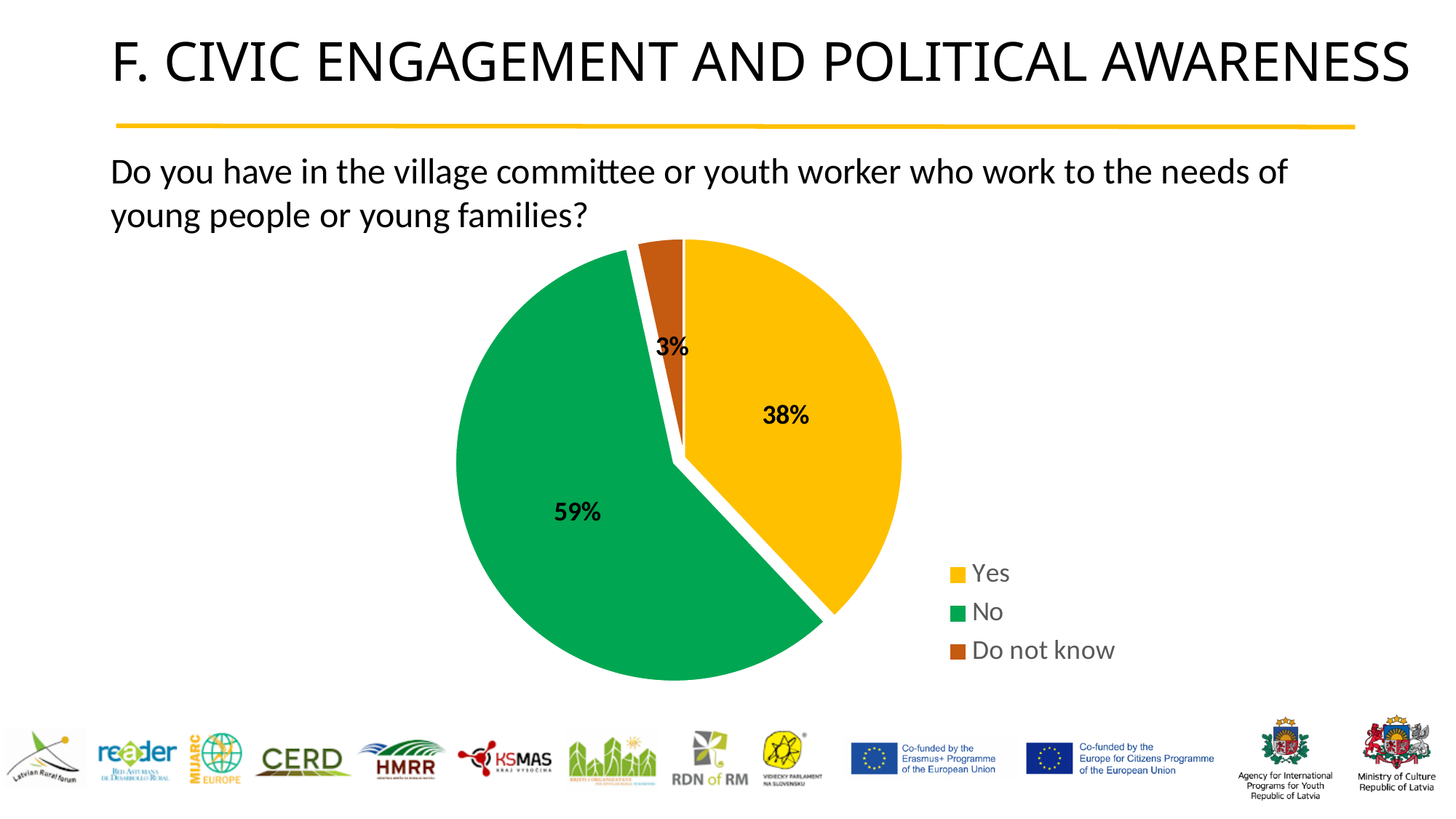
What share of respondents answered "Yes"? 38% What is the difference in percentage points between the "No" and "Yes" shares? 21 What colour is the "Yes" slice? yellow What share of respondents answered "No"? 59% How many categories does the pie chart show? 3 Which is larger, the share for "Yes" or the share for "Do not know"? Yes Which response has the smallest share of the pie? Do not know How many entries does the legend list? 3 What colour is the "No" slice? green What share of respondents answered "Do not know"? 3% What type of chart is shown on the slide? pie chart Which response has the largest share of the pie? No